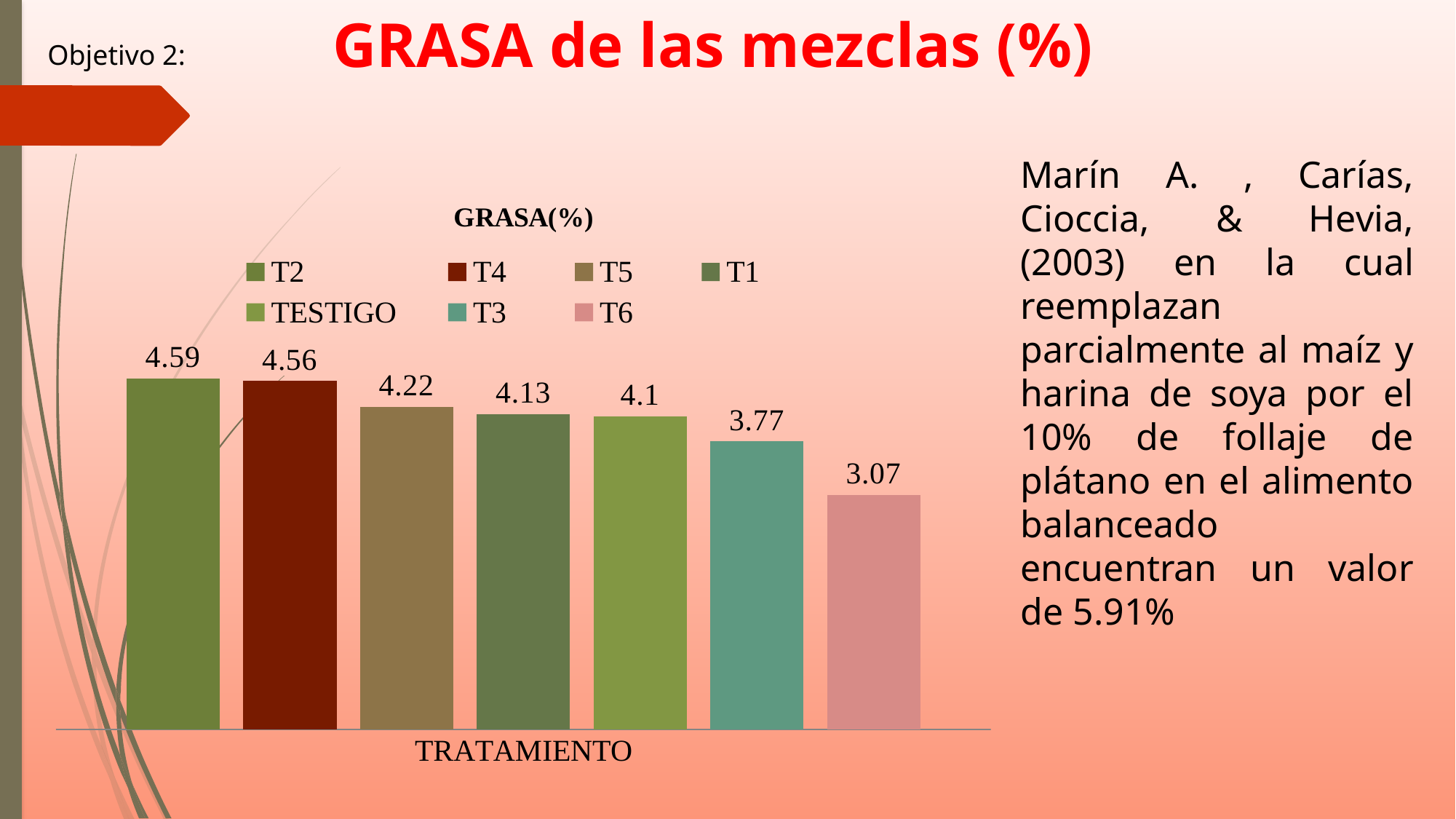
Which treatment has the lowest GRASA(%) value? T6 What is the GRASA(%) value for T3? 3.77 What type of chart is shown on the slide? Bar chart What is the GRASA(%) value for T2? 4.59 Which has a larger GRASA(%) value, T3 or TESTIGO? TESTIGO What is the GRASA(%) value for T6? 3.07 Which treatment has the highest GRASA(%) value? T2 What is the difference between the GRASA(%) values of T5 and T1? 0.09 How many entries does the chart legend list? 7 How many bars are plotted in the chart? 7 Do the GRASA(%) values rise or fall from left to right across the bars? Fall What is the GRASA(%) value for TESTIGO? 4.1